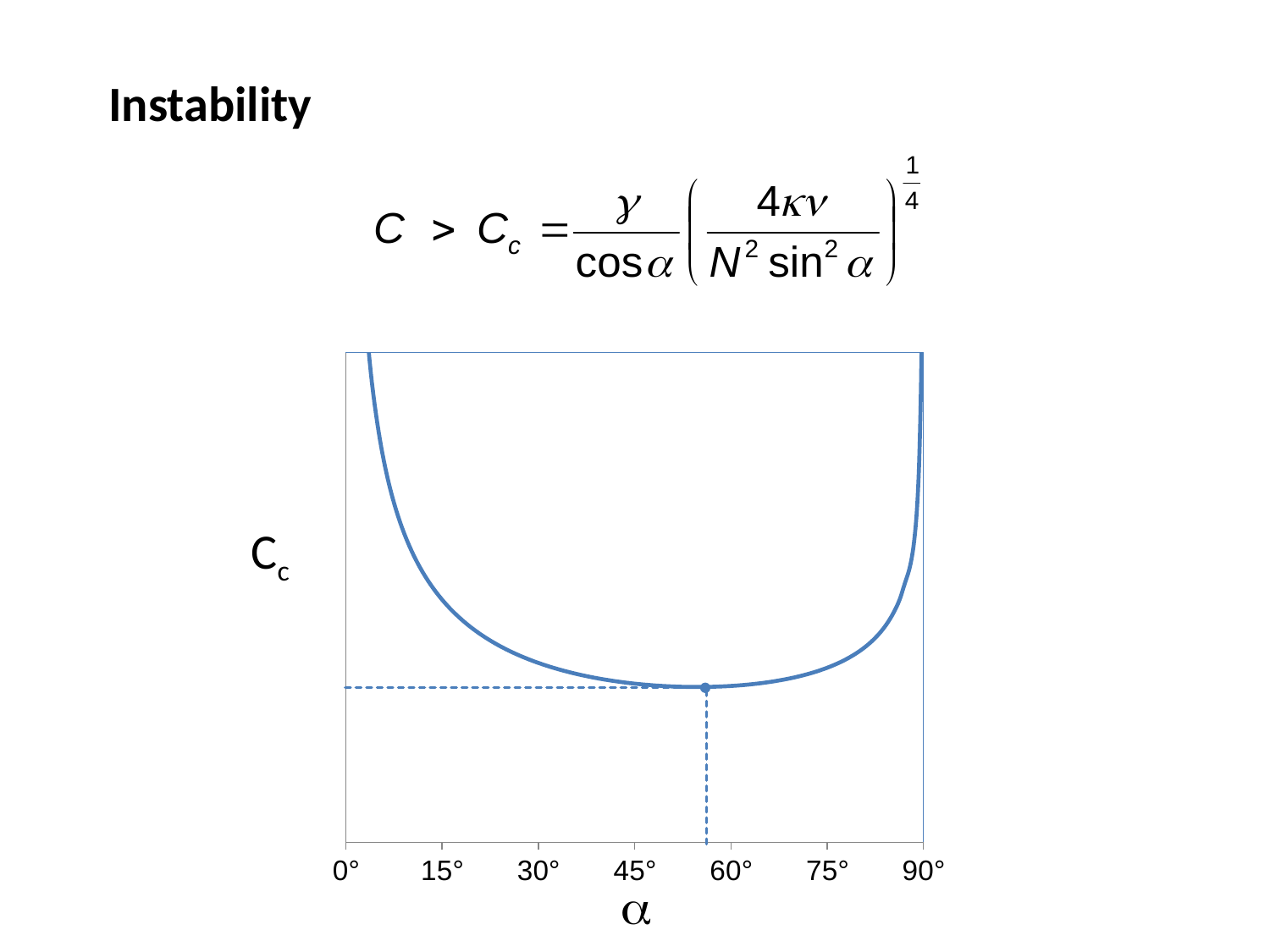
Is the value of Cc larger at 15° or at 45°? 15° Does the curve rise or fall as α increases from 60° to 90°? rise Is the value of Cc larger at 75° or at 60°? 75° How many tick labels are shown on the x axis of the chart? 7 Between which two labelled x-axis ticks does the marked minimum of the curve lie? 45° and 60° What is the label on the x axis of the chart? α What is the last tick label on the x axis? 90° Does the curve rise or fall as α increases from 0° to 45°? fall What is the first tick label on the x axis? 0° Is the value of Cc at 30° greater or less than the value at 60°? greater What kind of chart is shown on the slide? line chart What is the label on the y axis of the chart? Cc